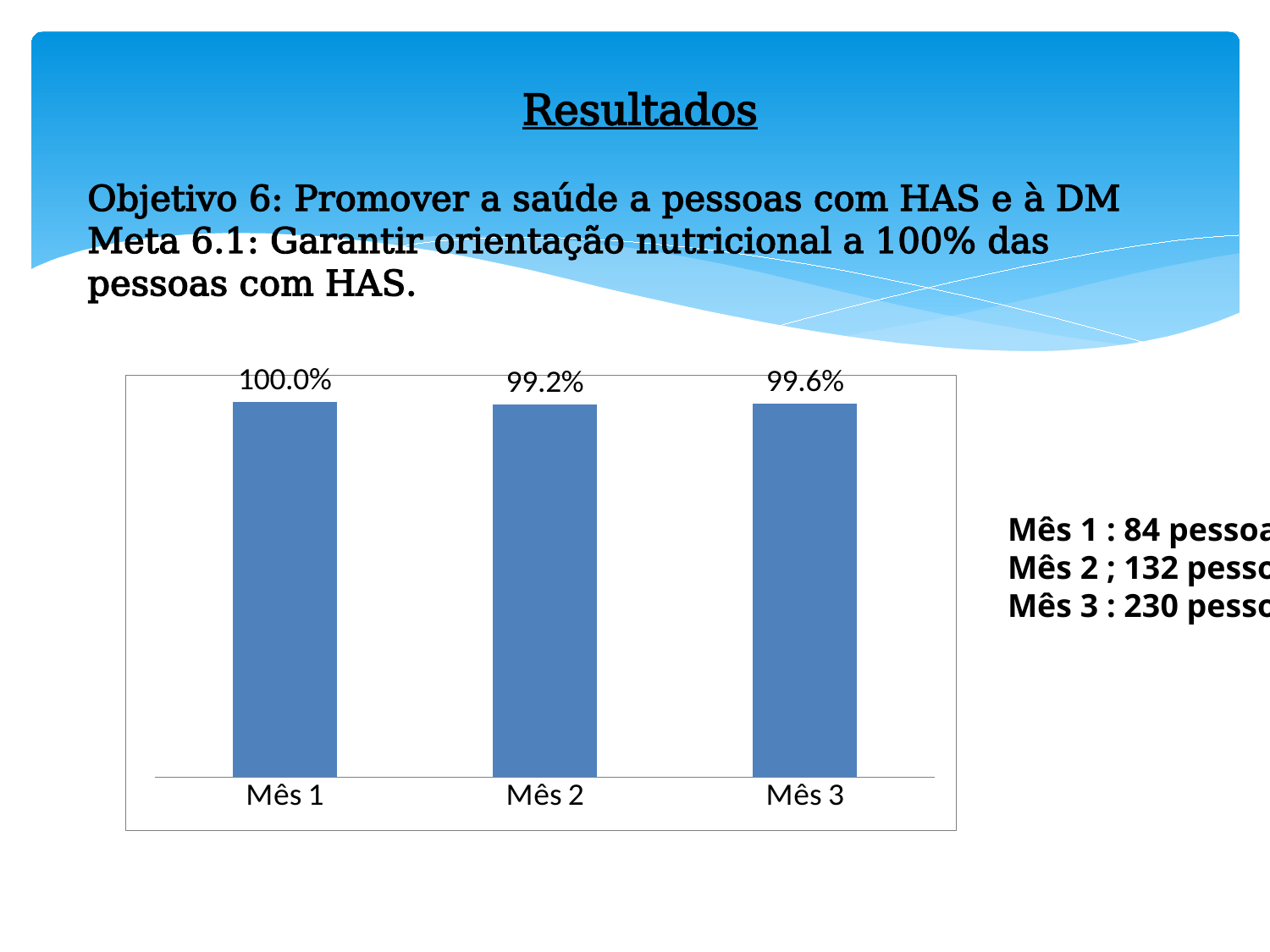
Which month has the lowest value? Mês 2 Does the value rise or fall from Mês 1 to Mês 2? Fall What is the difference between the values for Mês 3 and Mês 2? 0.4% What is the difference between the values for Mês 1 and Mês 2? 0.8% Which month has the highest value? Mês 1 What is the value for Mês 1? 100.0% How many bars are shown in the chart? 3 What is the value for Mês 2? 99.2% What kind of chart is shown on the slide? Bar chart What colour are the bars in the chart? Blue Which is larger, the value for Mês 2 or the value for Mês 3? Mês 3 What is the value for Mês 3? 99.6%